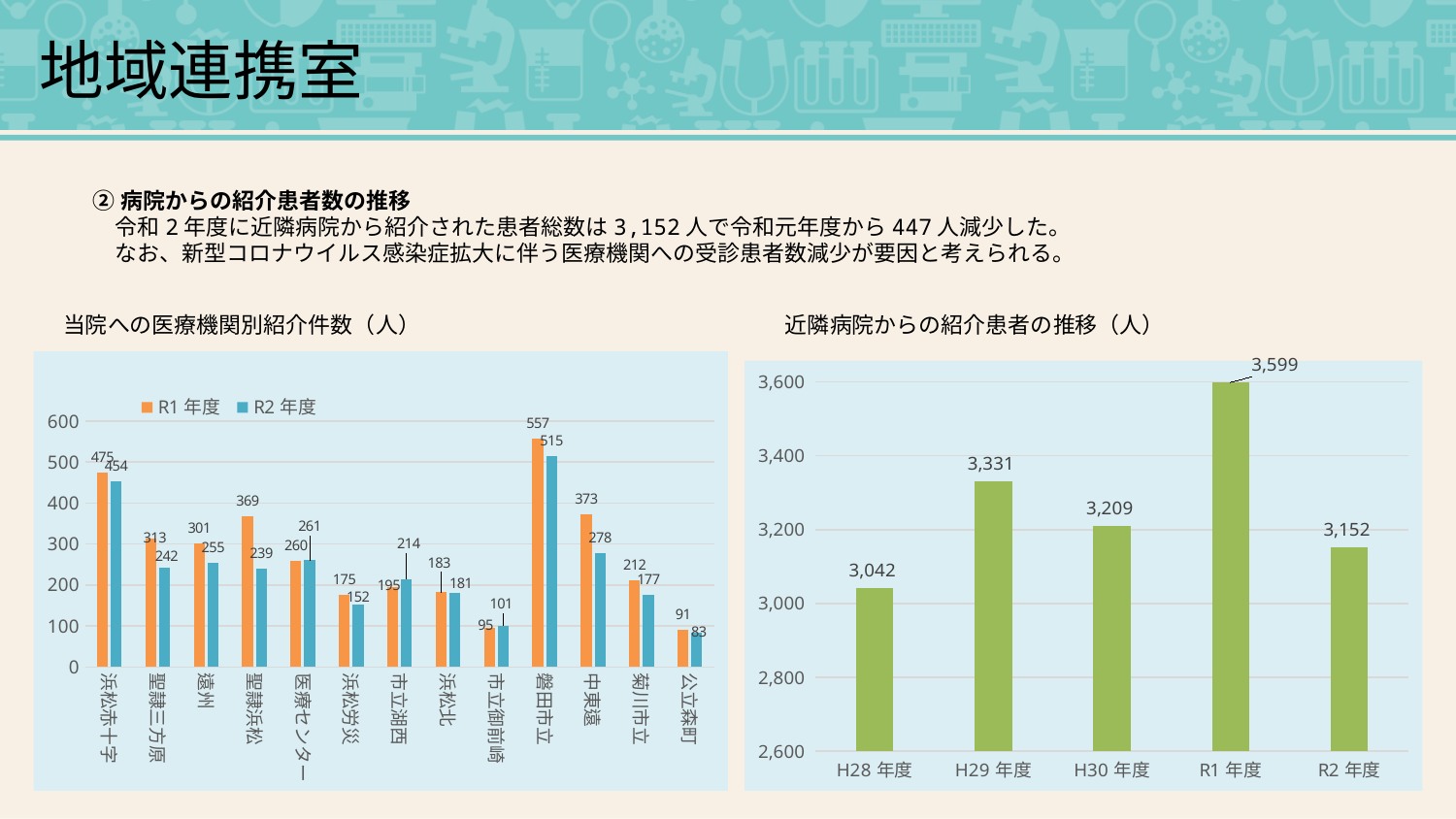
In the chart titled 近隣病院からの紹介患者の推移（人）, how many years are shown on the x axis? 5 In the chart titled 近隣病院からの紹介患者の推移（人）, which year has the lowest value? H28 年度 What kind of chart is the chart titled 当院への医療機関別紹介件数（人）? Bar chart In the chart titled 近隣病院からの紹介患者の推移（人）, what is the difference between R1 年度 and R2 年度? 447 In the chart titled 当院への医療機関別紹介件数（人）, what is the difference between the R1 年度 and R2 年度 values for 聖隷浜松? 130 In the chart titled 近隣病院からの紹介患者の推移（人）, what is the value for R1 年度? 3,599 In the chart titled 当院への医療機関別紹介件数（人）, what is the R2 年度 value for 磐田市立? 515 In the chart titled 当院への医療機関別紹介件数（人）, which is larger for 市立湖西: the R1 年度 value or the R2 年度 value? R2 年度 In the chart titled 近隣病院からの紹介患者の推移（人）, is the value for H30 年度 greater or less than 3,400? less In the chart titled 当院への医療機関別紹介件数（人）, which institution has the lowest R2 年度 value? 公立森町 In the chart titled 当院への医療機関別紹介件数（人）, which institution has the highest R1 年度 value? 磐田市立 In the chart titled 当院への医療機関別紹介件数（人）, how many series does the legend list? 2